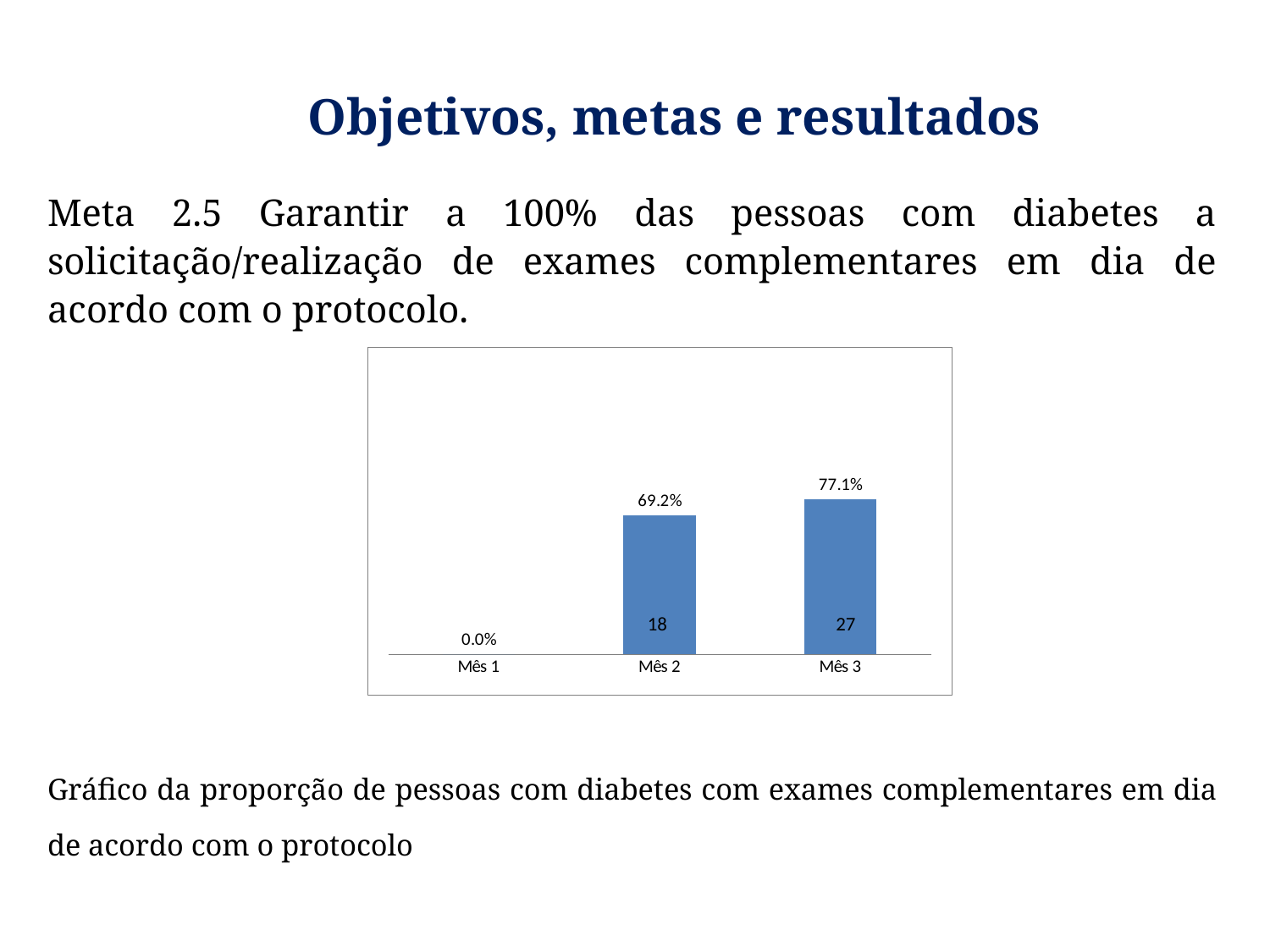
Do the percentages rise or fall from Mês 1 to Mês 3? Rise What is the difference in percentage points between Mês 3 and Mês 2? 7.9 What number is printed inside the bar for Mês 3? 27 How many months (categories) are shown on the chart? 3 Which month has the highest percentage? Mês 3 Which is larger, the percentage for Mês 2 or for Mês 3? Mês 3 What is the percentage shown for Mês 3? 77.1% What is the percentage shown for Mês 2? 69.2% Which month has the lowest percentage? Mês 1 What number is printed inside the bar for Mês 2? 18 What kind of chart is shown on the slide? Bar chart What is the percentage shown for Mês 1? 0.0%